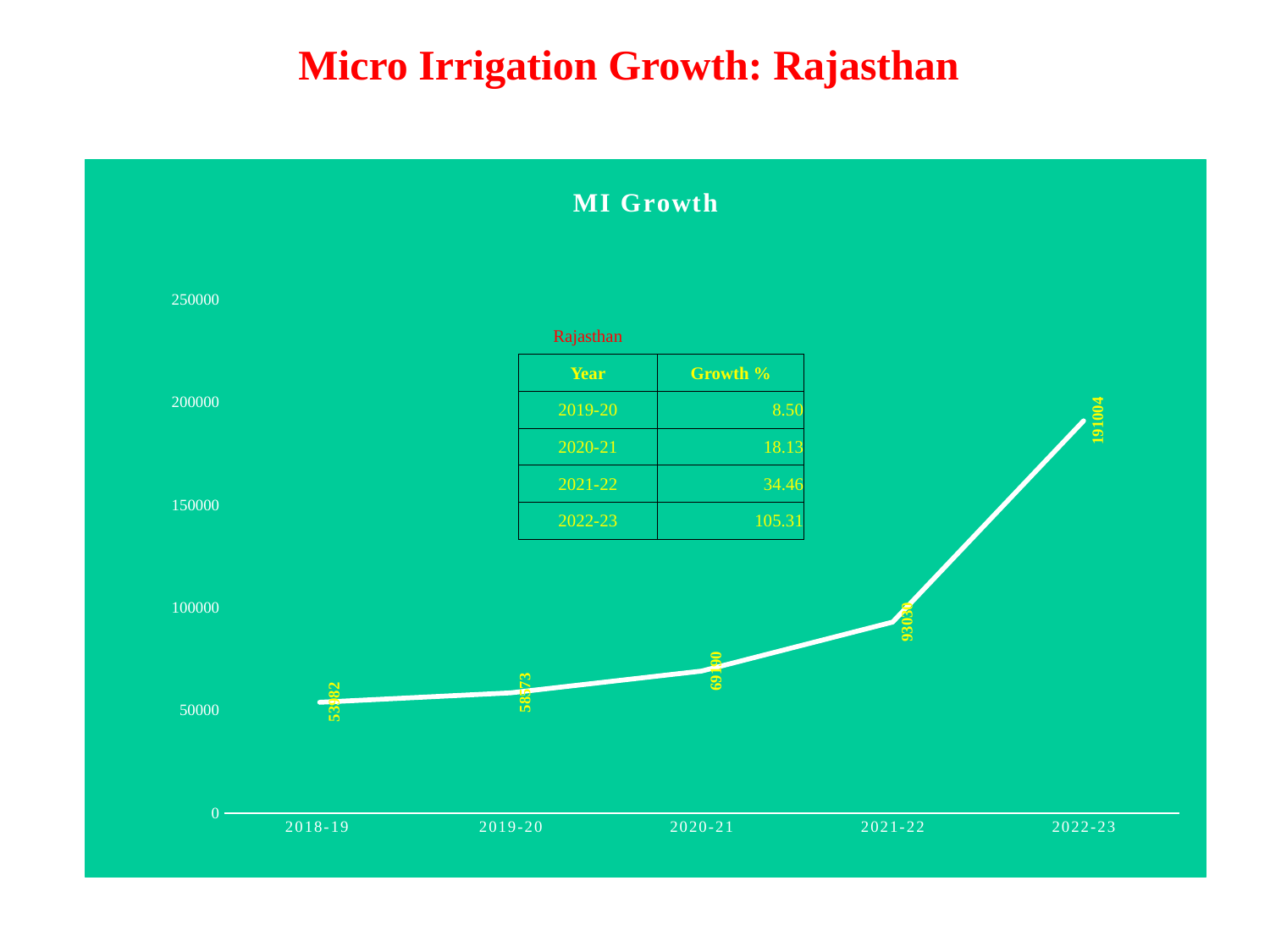
What is the title of the chart? MI Growth What is the value plotted for 2022-23? 191004 Which year has the highest value on the chart? 2022-23 According to the Rajasthan growth table on the chart, what is the Growth % for 2022-23? 105.31 Is the value for 2018-19 greater or less than 100000? less How many years are plotted along the x axis of the chart? 5 According to the Rajasthan growth table on the chart, what is the Growth % for 2019-20? 8.50 Is the value for 2022-23 greater or less than 150000? greater What type of chart is shown on the slide? Line chart Do the values rise or fall from 2018-19 to 2022-23? Rise Is the value for 2021-22 greater or less than 100000? less Which year has the lowest value on the chart? 2018-19